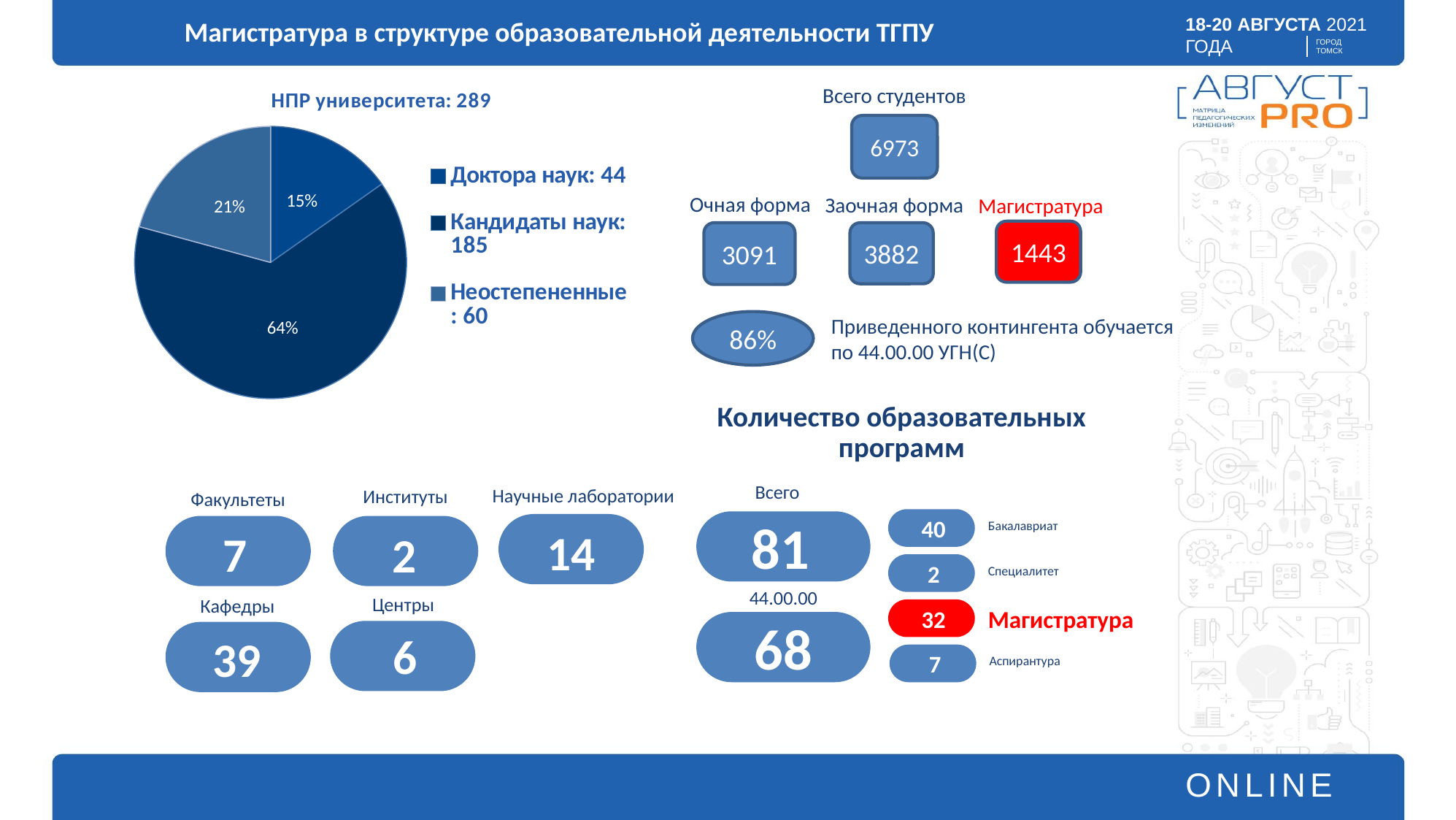
How many entries does the legend of the pie chart "НПР университета: 289" list? 3 In the pie chart "НПР университета: 289", what share of the pie is "Неостепененные"? 21% What kind of chart is shown under the title "НПР университета: 289"? pie chart In the pie chart "НПР университета: 289", what share of the pie is "Доктора наук"? 15% Which category is the smallest slice in the pie chart "НПР университета: 289"? Доктора наук In the pie chart "НПР университета: 289", which is larger: "Неостепененные" or "Доктора наук"? Неостепененные How many slices does the pie chart "НПР университета: 289" have? 3 According to the legend of the pie chart "НПР университета: 289", how many "Доктора наук" are there? 44 In the pie chart "НПР университета: 289", what share of the pie is "Кандидаты наук"? 64% According to the legend of the pie chart "НПР университета: 289", how many "Кандидаты наук" are there? 185 In the pie chart "НПР университета: 289", what is the difference between the number of "Кандидаты наук" and "Доктора наук"? 141 Which category is the largest slice in the pie chart "НПР университета: 289"? Кандидаты наук